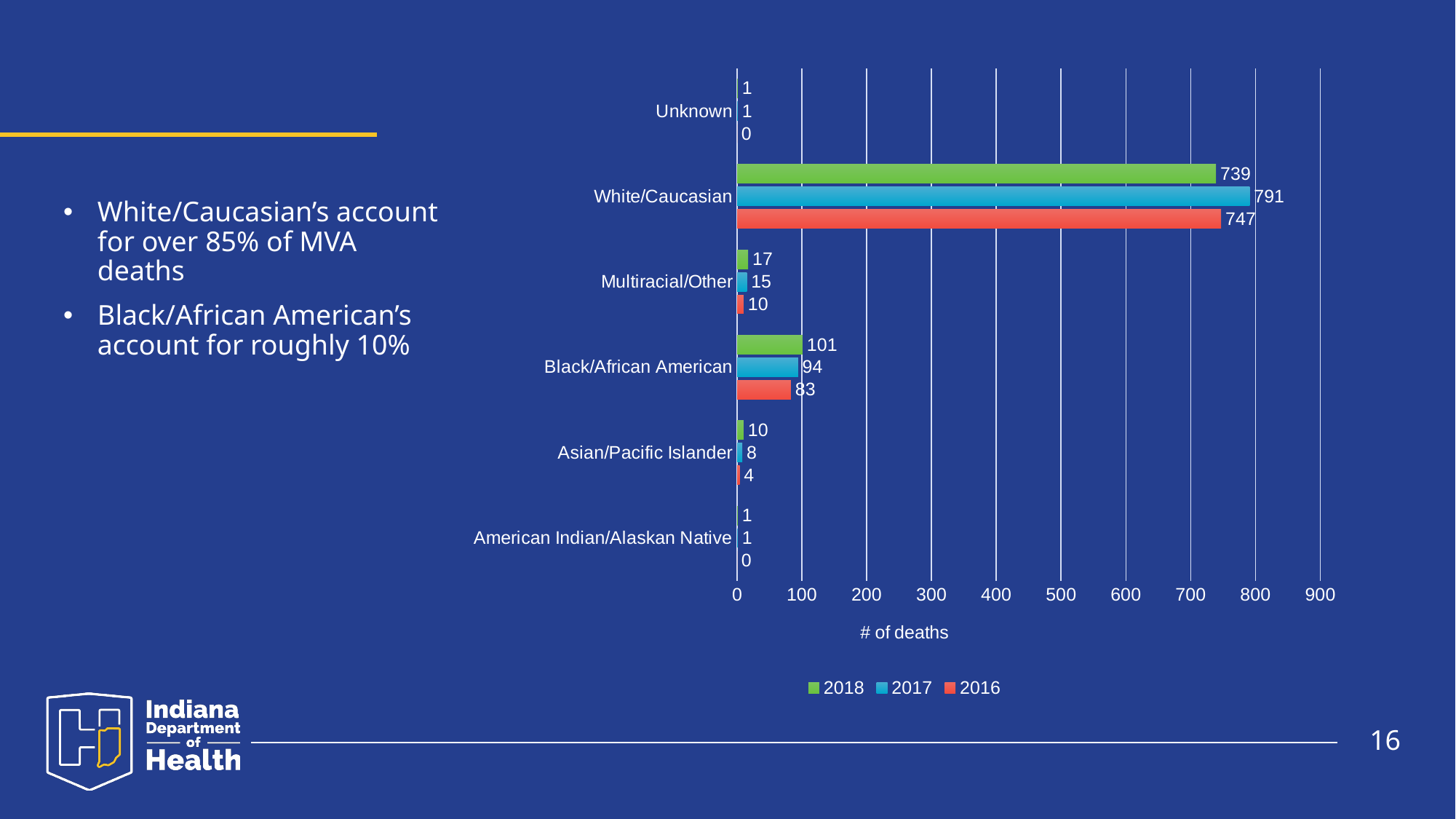
What is the number of deaths for White/Caucasian in 2017? 791 What is the number of deaths for Black/African American in 2018? 101 What is the x-axis title of the chart? # of deaths What is the number of deaths for Multiracial/Other in 2016? 10 What is the difference between the 2018 and 2016 values for Black/African American? 18 How many categories are shown on the y axis? 6 What kind of chart is shown on the slide? Bar chart Which is larger for White/Caucasian: the 2016 value or the 2018 value? 2016 What is the difference between the 2017 and 2018 values for White/Caucasian? 52 Which category has the highest number of deaths in 2018? White/Caucasian What is the number of deaths for Asian/Pacific Islander in 2017? 8 How many series does the legend list? 3